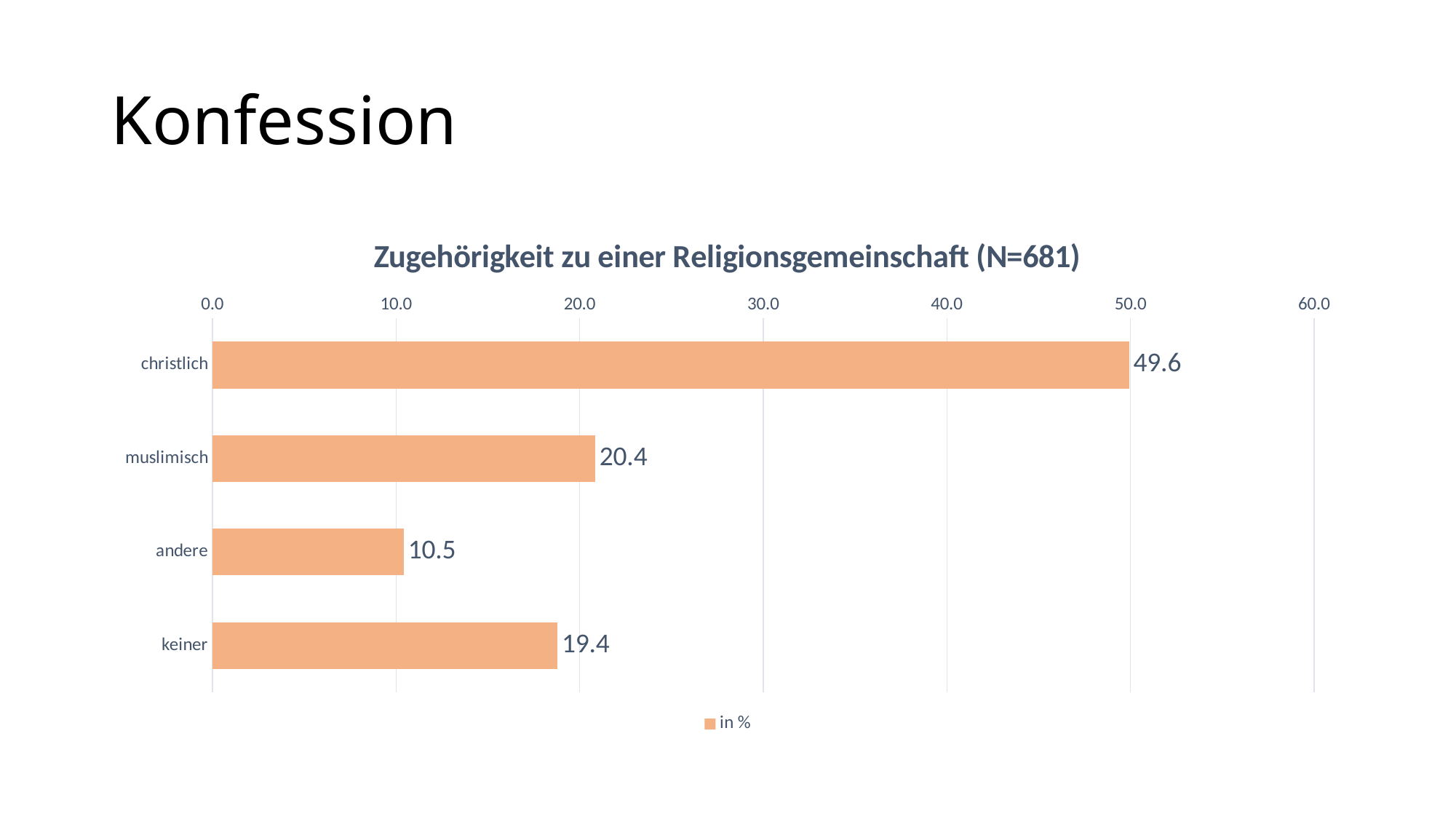
Is the value for christlich greater or less than 40.0? greater What is the value for muslimisch? 20.4 What is the value for christlich? 49.6 Which is larger, the value for muslimisch or the value for keiner? muslimisch What is the value for andere? 10.5 What is the difference between the values for christlich and muslimisch? 29.2 Which category has the highest value? christlich What is the title of the chart? Zugehörigkeit zu einer Religionsgemeinschaft (N=681) What is the value for keiner? 19.4 How many categories are shown in the chart? 4 Which category has the lowest value? andere What kind of chart is shown on the slide? bar chart